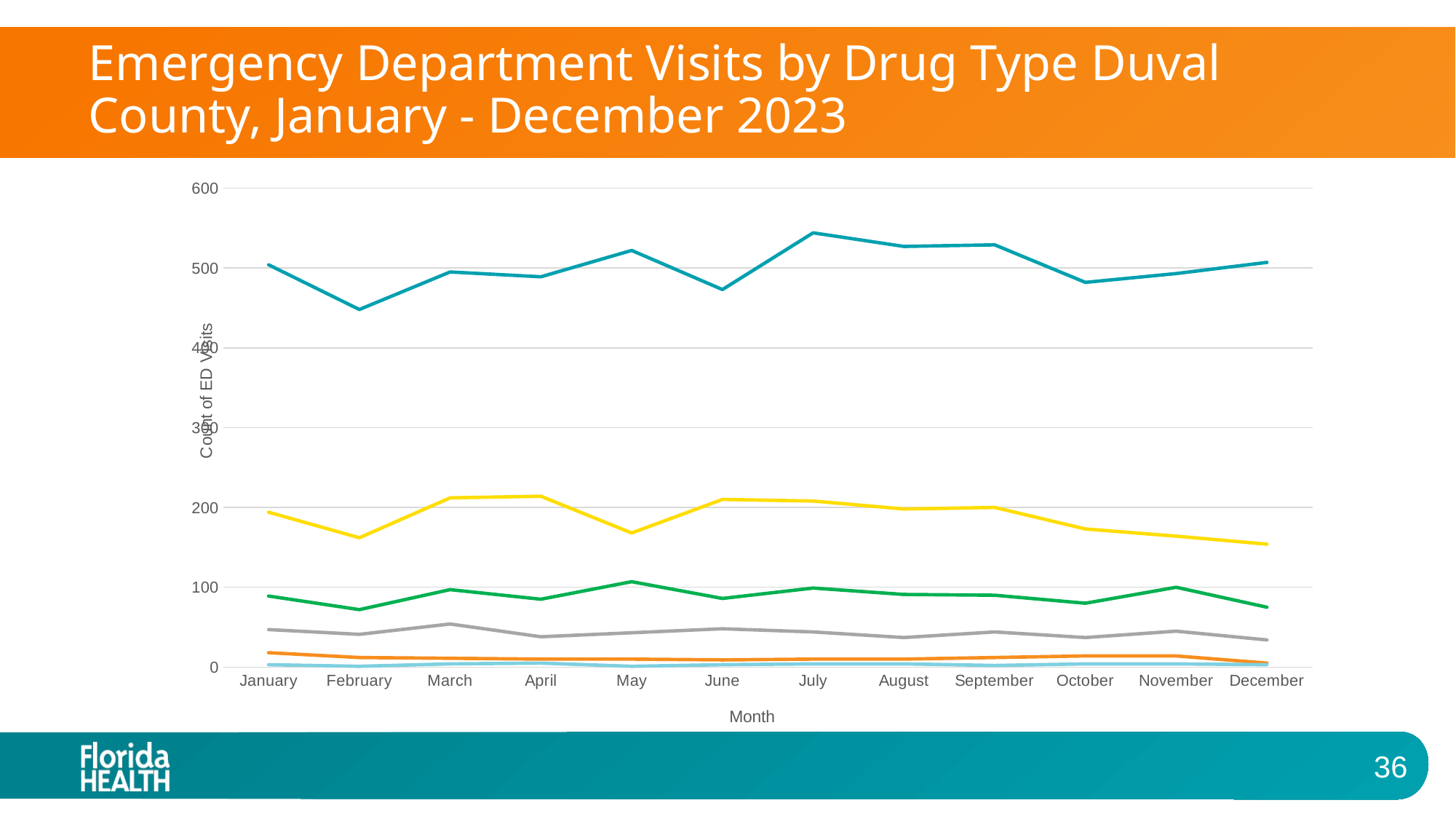
What is the label of the y axis? Count of ED Visits Is the value of the yellow line in February greater or less than 200? less In which month does the teal (top) line reach its highest value? July Is the value of the green line in February greater or less than 100? less What kind of chart is shown on the slide? line chart In which month does the teal (top) line reach its lowest value? February Which is larger for the yellow line: the value in March or the value in May? March Does the yellow line rise or fall from September to December? fall What is the title of the chart? Emergency Department Visits by Drug Type Duval County, January - December 2023 How many months are plotted along the x axis? 12 Is the value of the teal (top) line in July greater or less than 500? greater